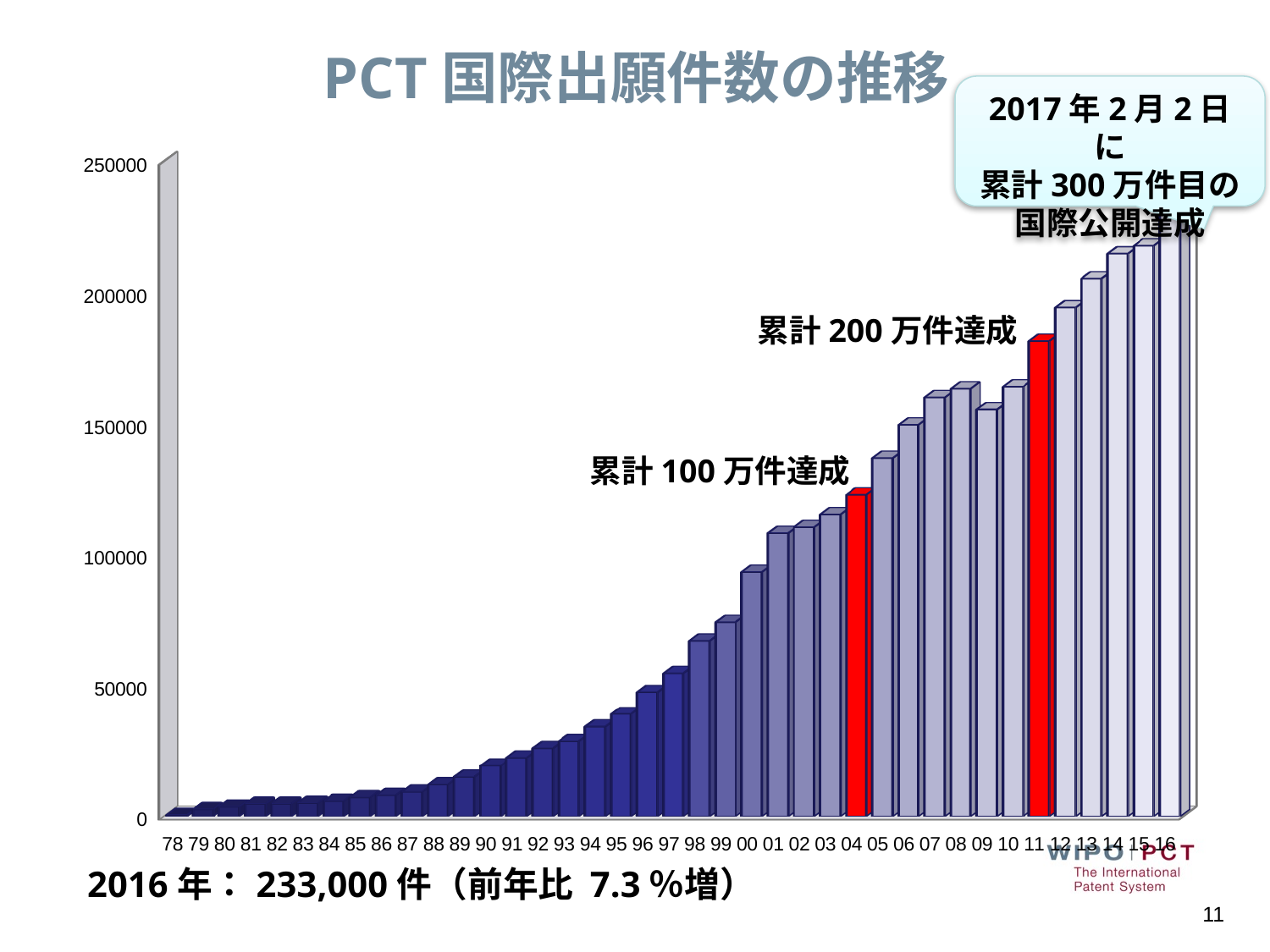
What kind of chart is shown on the slide? bar chart Do the values generally rise or fall from 78 to 16? rise Which year has the highest number of PCT international applications? 16 Which is larger, the value for 08 or the value for 09? 08 How many years (categories) are shown on the x axis? 39 Is the value for 11 greater or less than 200000? less Is the value for 04 greater or less than 100000? greater How many PCT international applications were filed in 2016, according to the slide? 233,000 件 Which year has the lowest number of PCT international applications? 78 Is the value for 95 greater or less than 50000? less What is the title of the chart? PCT 国際出願件数の推移 Which two years are highlighted with red bars? 04 and 11